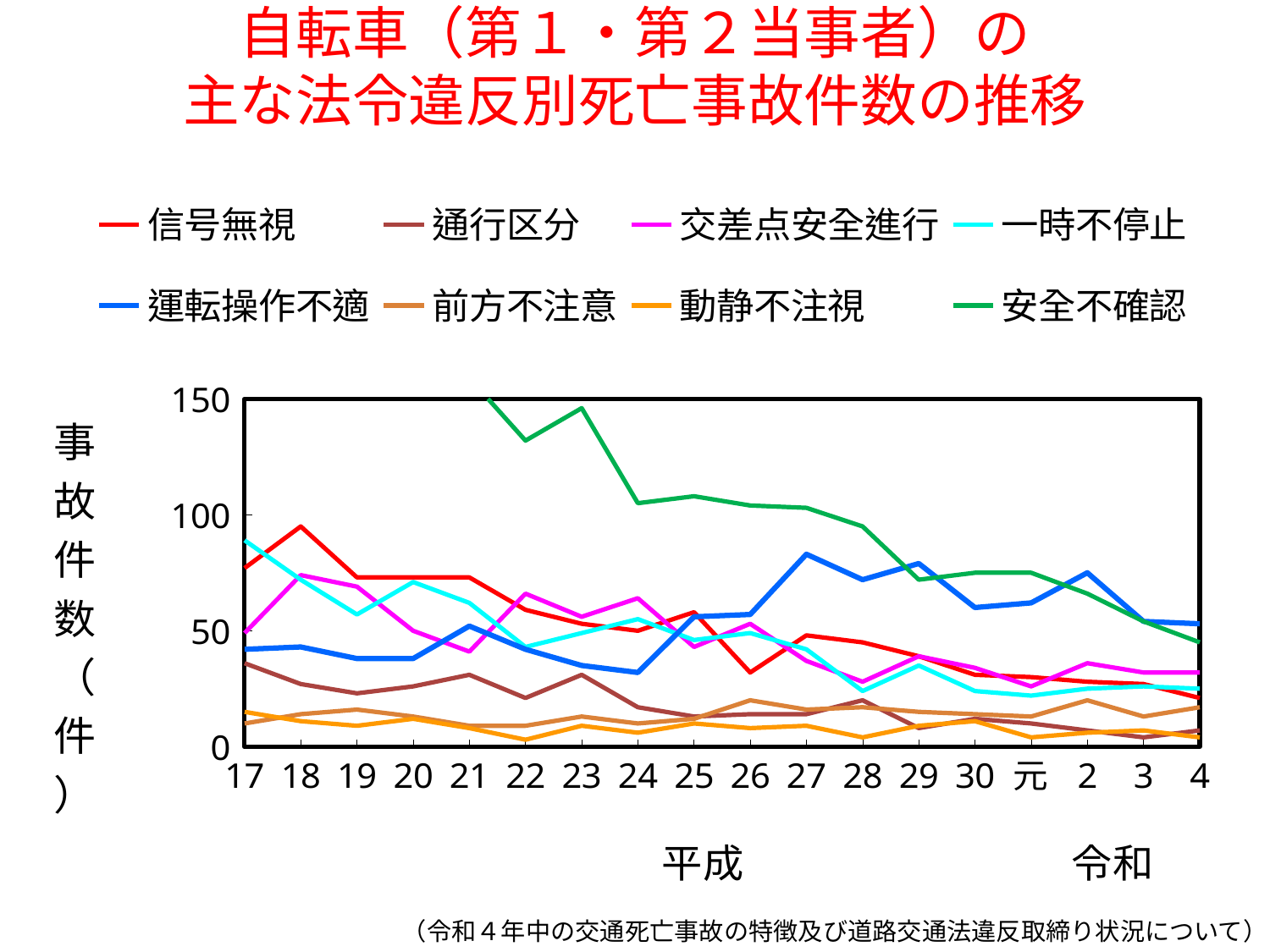
What colour is the line for 安全不確認 in the legend? green Is the value for 安全不確認 in 令和4 greater or less than 50? less Which series has the highest value in 平成27? 安全不確認 Is the value for 信号無視 in 平成18 greater or less than 50? greater Which series has the lowest value in 平成22? 動静不注視 How many series does the legend list? 8 Does the value for 安全不確認 generally rise or fall from 平成22 to 令和4? fall What kind of chart is shown on the slide? line chart How many years (points) are shown along the x axis? 18 In 平成18, which is larger: the value for 信号無視 or the value for 運転操作不適? 信号無視 Is the value for 動静不注視 in 平成22 greater or less than 50? less